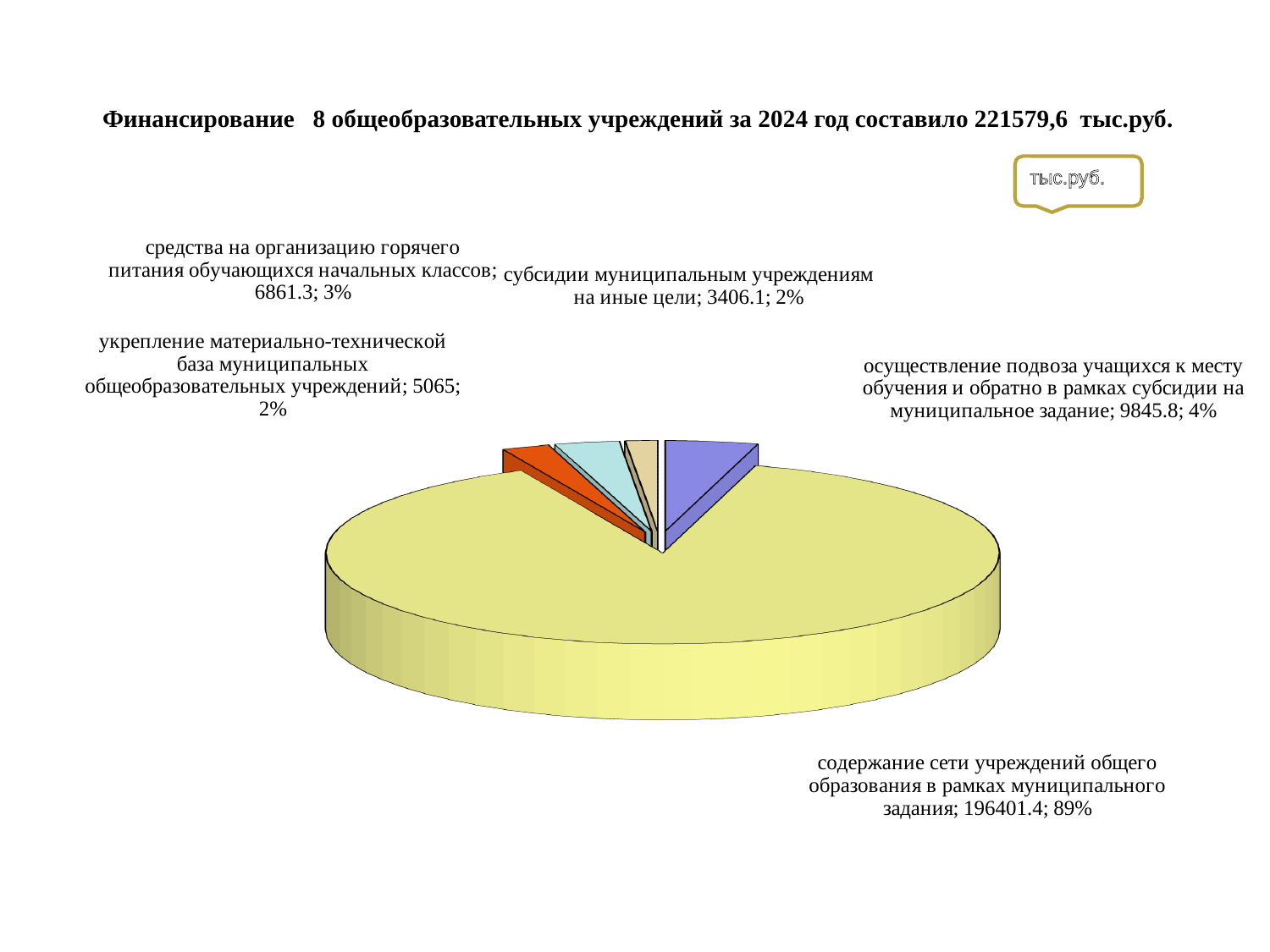
What is the value for 'осуществление подвоза учащихся к месту обучения и обратно в рамках субсидии на муниципальное задание'? 9845.8 What share of the pie does 'осуществление подвоза учащихся к месту обучения и обратно в рамках субсидии на муниципальное задание' represent? 4% What is the value for 'субсидии муниципальным учреждениям на иные цели'? 3406.1 Which category has the smallest slice of the pie? субсидии муниципальным учреждениям на иные цели What kind of chart is shown on the slide? pie chart What share of the pie does 'средства на организацию горячего питания обучающихся начальных классов' represent? 3% According to the slide title, what was the total financing of the 8 general education institutions in 2024? 221579,6 тыс.руб. How many slices does the pie chart have? 5 What is the difference between the value for 'осуществление подвоза учащихся' (9845.8) and 'средства на организацию горячего питания' (6861.3)? 2984.5 Which category has the largest slice of the pie? содержание сети учреждений общего образования в рамках муниципального задания Which is larger: the value for 'укрепление материально-технической база муниципальных общеобразовательных учреждений' or for 'субсидии муниципальным учреждениям на иные цели'? укрепление материально-технической база муниципальных общеобразовательных учреждений What is the value for 'содержание сети учреждений общего образования в рамках муниципального задания'? 196401.4